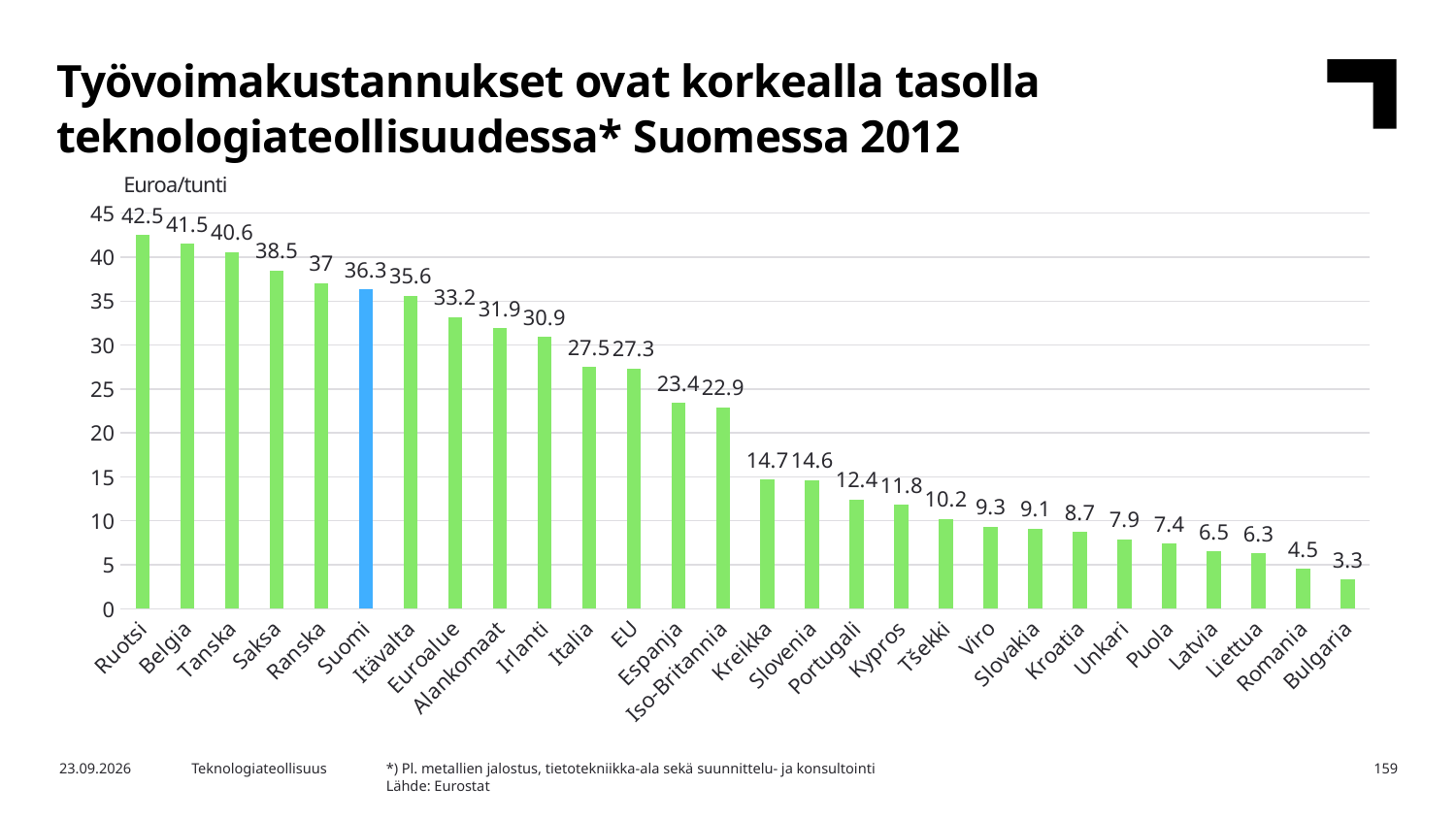
Which country has the highest value? Ruotsi Which has a larger value, Espanja or Kreikka? Espanja Which country has the lowest value? Bulgaria How many countries or regions are shown on the chart? 28 What is the value for Saksa? 38.5 What unit is shown above the y axis? Euroa/tunti What is the difference between the values for Ruotsi and Suomi? 6.2 What is the value for EU? 27.3 Do the values rise or fall from left to right along the x axis? Fall What kind of chart is shown on the slide? Bar chart What is the value for Bulgaria? 3.3 What is the value for Suomi? 36.3